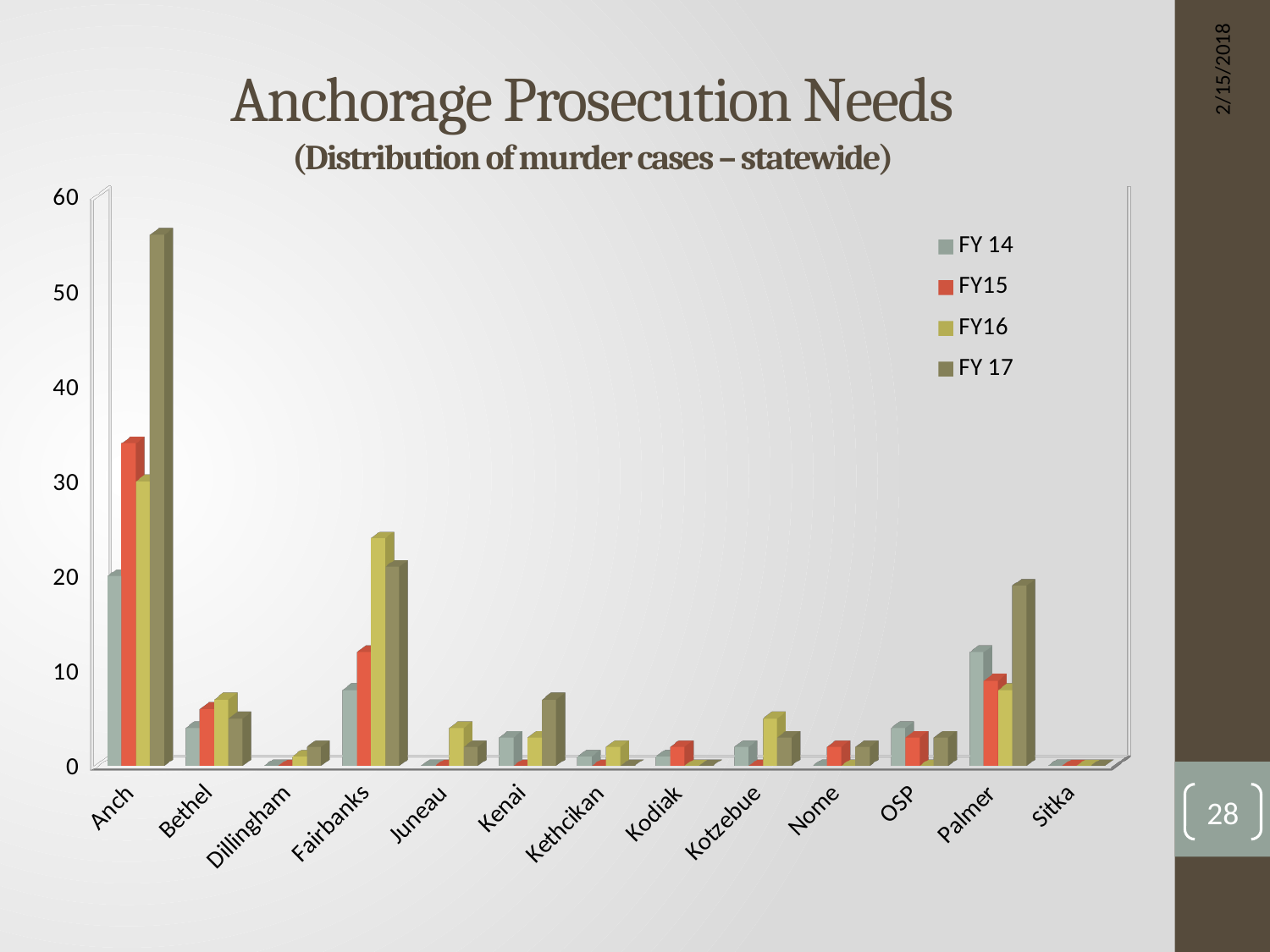
For Palmer, which is larger: the FY 14 value or the FY16 value? FY 14 Is the FY 17 value for Palmer greater or less than 10? greater Is the FY15 value for Anch greater or less than 30? greater What kind of chart is shown on the slide? Bar chart How many series does the legend list? 4 What are the entries listed in the legend? FY 14, FY15, FY16, FY 17 Is the FY 17 value for Anch greater or less than 50? greater What is the title of the chart? Anchorage Prosecution Needs (Distribution of murder cases – statewide) How many categories are shown along the x axis? 13 For Anch, which is larger: the FY15 value or the FY16 value? FY15 Which category has the highest FY 17 value? Anch